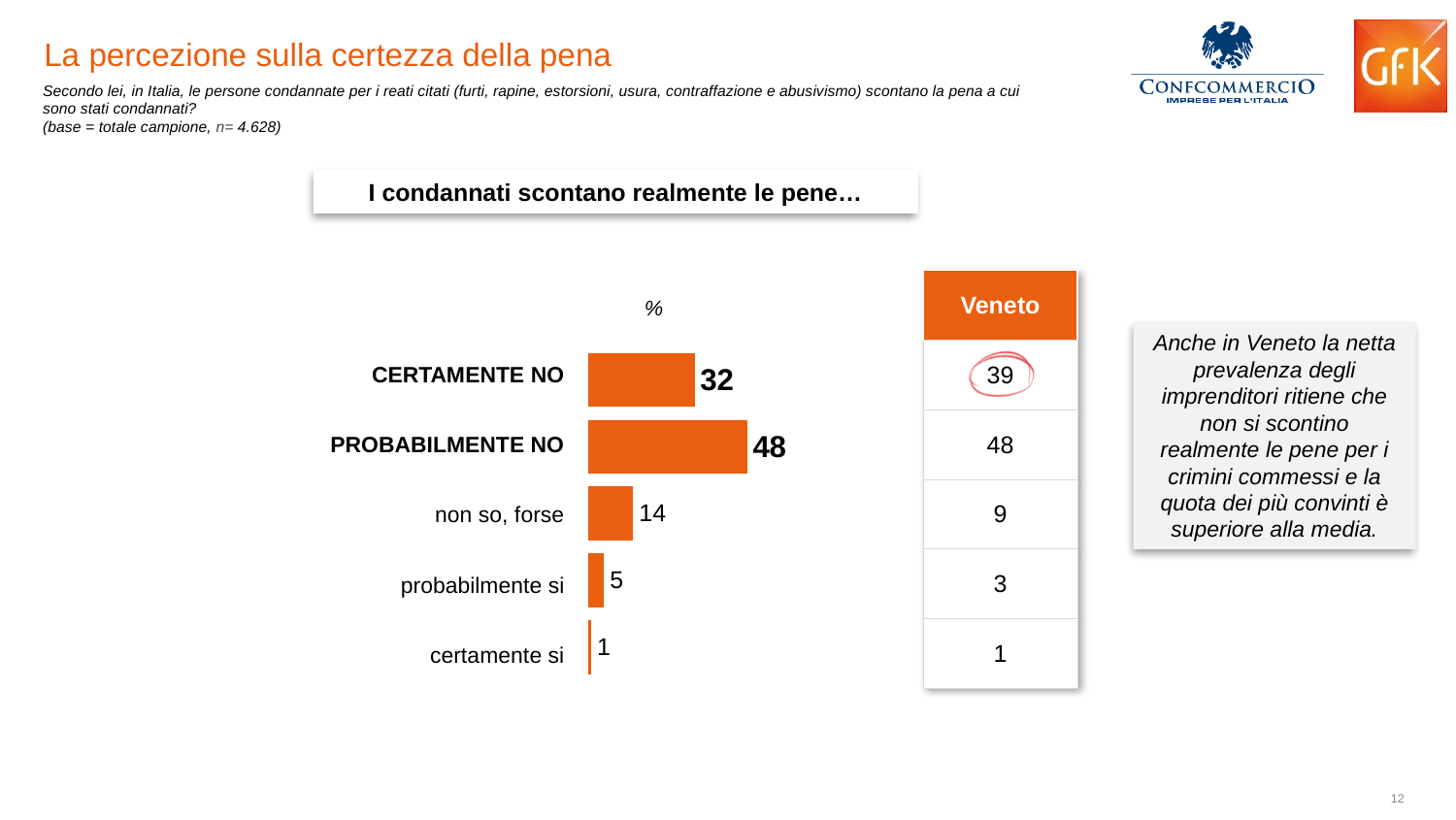
What is the value for PROBABILMENTE NO in the bar chart? 48 What is the value for 'probabilmente si' in the bar chart? 5 What is the value for CERTAMENTE NO in the bar chart? 32 Which category has the highest value in the bar chart? PROBABILMENTE NO What is the value for 'non so, forse' in the bar chart? 14 Which is larger in the bar chart: the value for 'non so, forse' or the value for 'probabilmente si'? non so, forse Which category has the lowest value in the bar chart? certamente si What kind of chart is shown on the slide? bar chart What is the title shown above the bar chart? I condannati scontano realmente le pene… What is the difference between the values for 'non so, forse' and 'certamente si' in the bar chart? 13 What is the difference between the values for PROBABILMENTE NO and CERTAMENTE NO in the bar chart? 16 How many categories are shown in the bar chart? 5